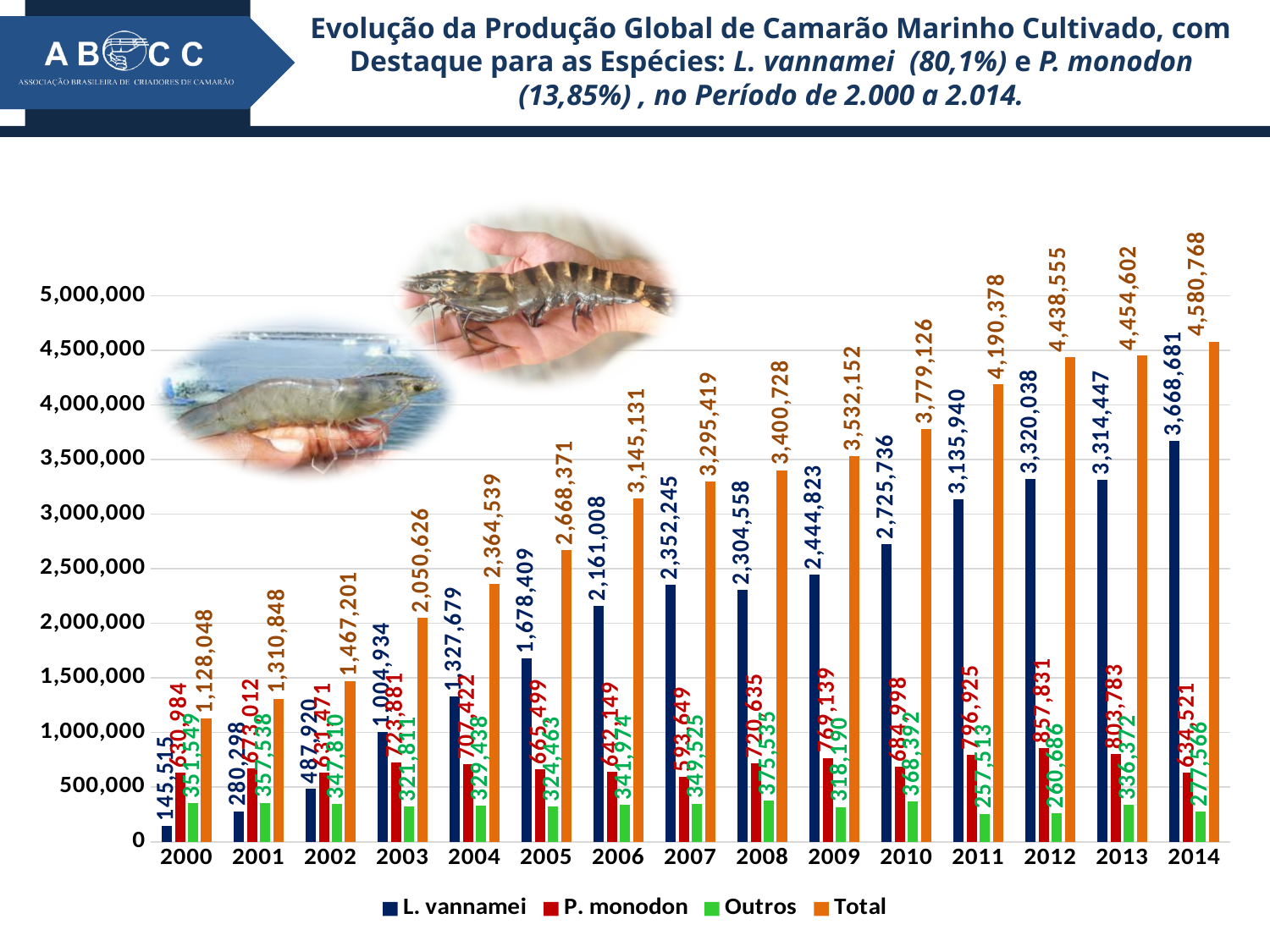
What is the difference between the Total values for 2014 and 2000? 3,452,720 What is the difference between the Total and the L. vannamei value in 2014? 912,087 What is the Total production value shown for 2014? 4,580,768 Which is larger: the L. vannamei value in 2007 or in 2008? 2007 In which year is the Total production highest? 2014 What is the L. vannamei production value shown for 2000? 145,515 What is the Total production value shown for 2003? 2,050,626 Is the Total value for 2006 greater or less than 3,000,000? greater How many series does the legend list? 4 In which year is the L. vannamei production lowest? 2000 How many years are shown on the x axis? 15 What is the L. vannamei value shown for 2010? 2,725,736